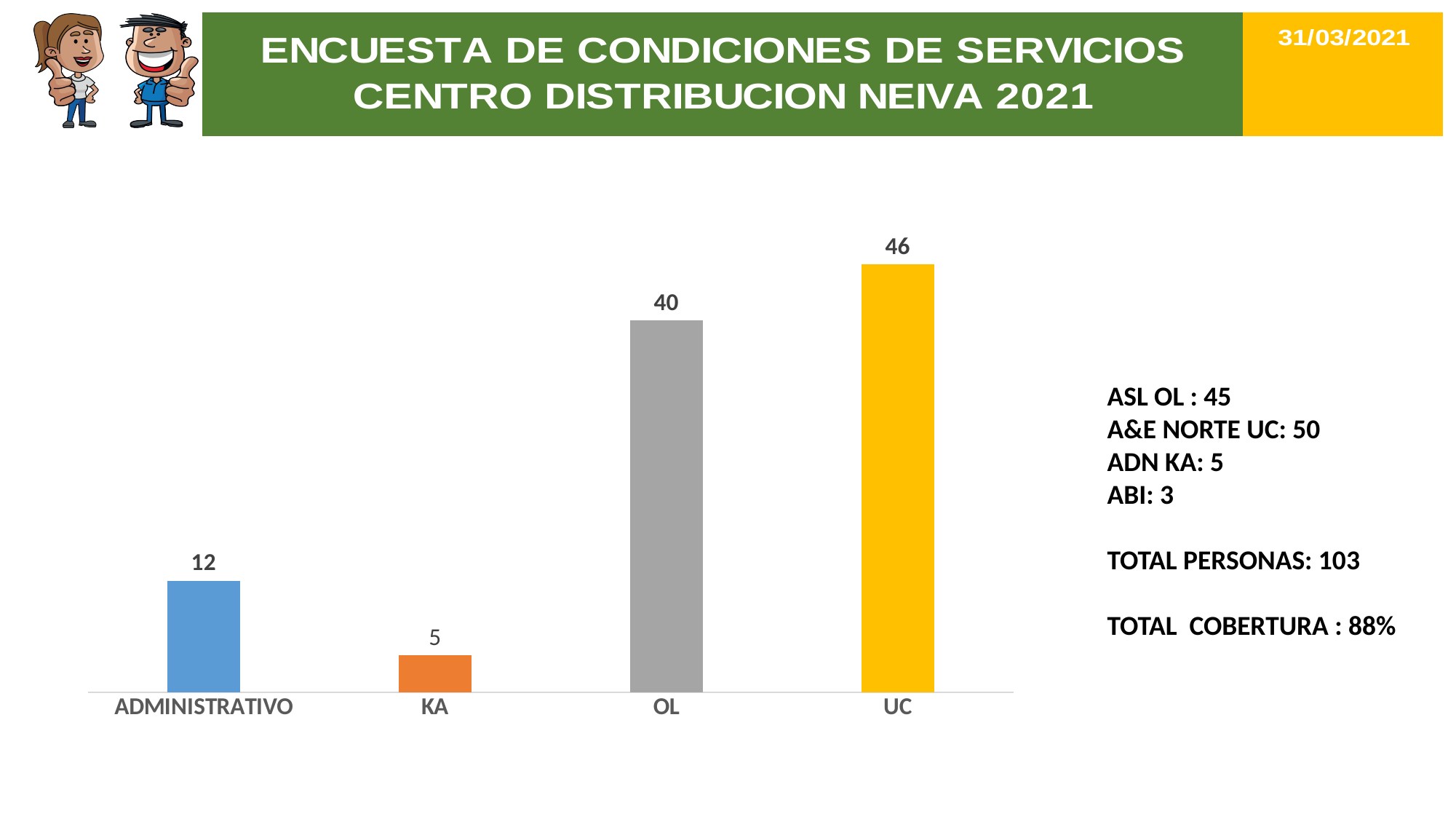
What is the difference between the values for ADMINISTRATIVO and KA? 7 What colour is the bar for UC? Yellow What is the difference between the values for UC and OL? 6 What is the value for KA? 5 What is the value for UC? 46 What is the value for ADMINISTRATIVO? 12 What is the value for OL? 40 Which category has the lowest value? KA What kind of chart is shown on the slide? Bar chart Which category has the highest value? UC Which is larger, the value for OL or the value for ADMINISTRATIVO? OL How many categories are shown on the x axis? 4